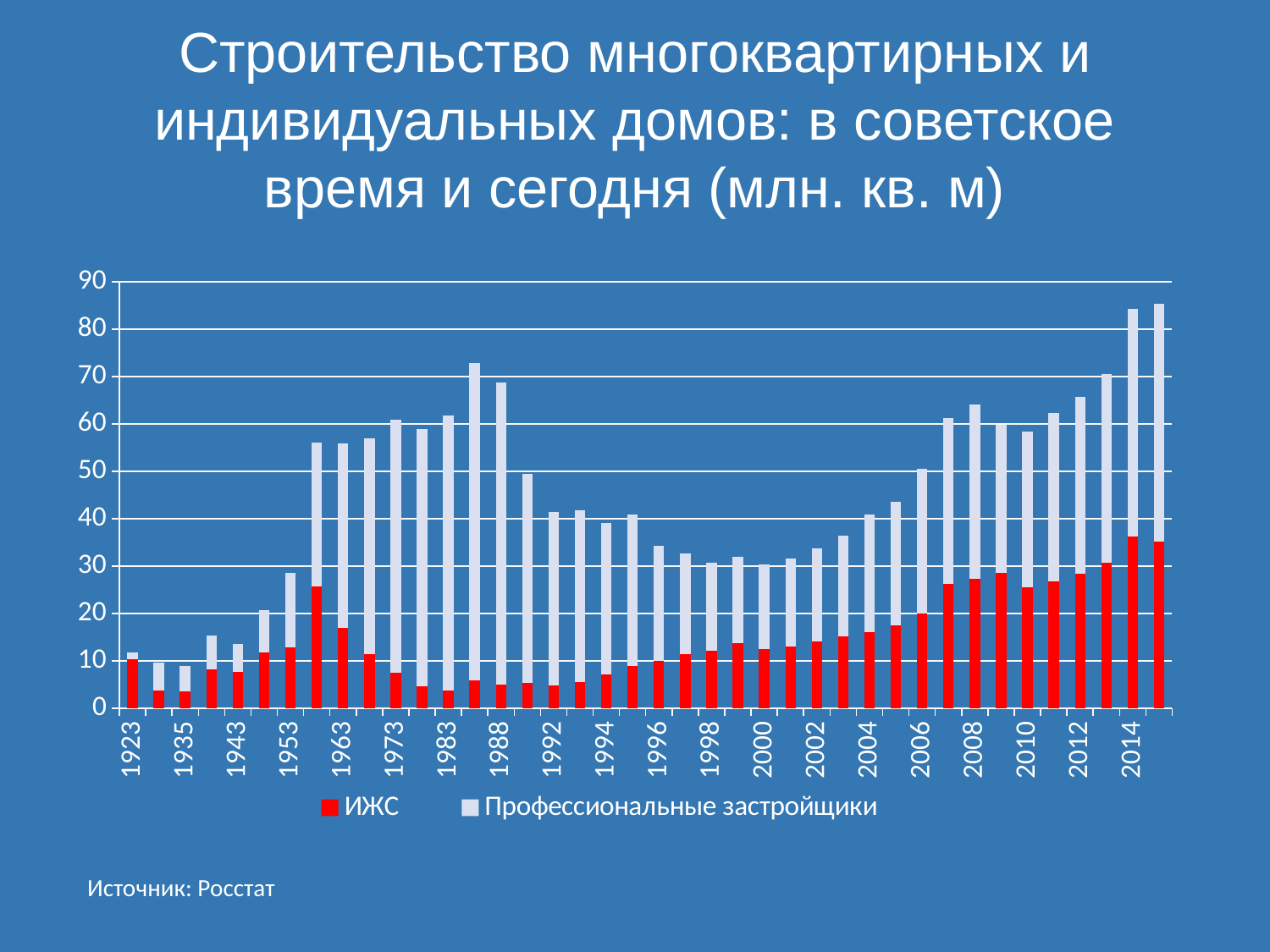
Which year has the larger total bar, 2014 or 1988? 2014 What kind of chart is shown on the slide? stacked bar chart Which year has the larger ИЖС value, 2014 or 1923? 2014 Is the ИЖС value for 1963 greater or less than 20? less Is the ИЖС value for 2014 greater or less than 30? greater Is the total height of the bar for 1988 greater or less than 60? greater Which series is shown in red? ИЖС What are the two series named in the legend? ИЖС and Профессиональные застройщики How many series does the legend list? 2 Do the total bar heights generally rise or fall from 1998 to 2014? rise